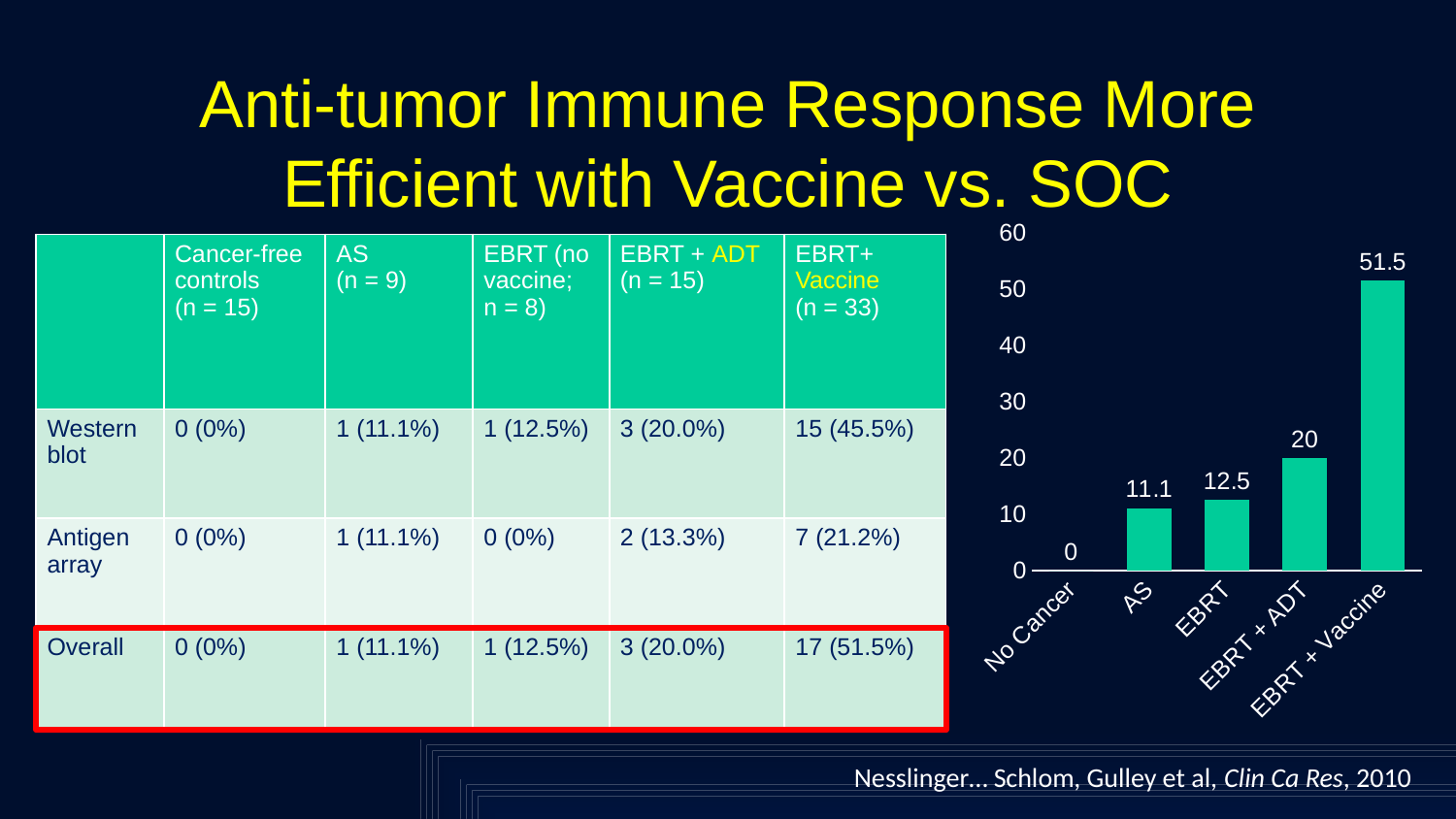
Which category has the highest value in the bar chart? EBRT + Vaccine What kind of chart is shown on the right side of the slide? bar chart What is the value for AS in the bar chart? 11.1 What is the difference between the values for EBRT + Vaccine and EBRT + ADT in the bar chart? 31.5 Which is larger in the bar chart, the value for EBRT + ADT or the value for EBRT? EBRT + ADT How many categories are shown on the x axis of the bar chart? 5 What is the value for No Cancer in the bar chart? 0 Which category has the lowest value in the bar chart? No Cancer What is the value for EBRT + Vaccine in the bar chart? 51.5 What is the value for EBRT + ADT in the bar chart? 20 Is the value for EBRT + Vaccine in the bar chart greater or less than 40? greater What is the difference between the values for EBRT and AS in the bar chart? 1.4